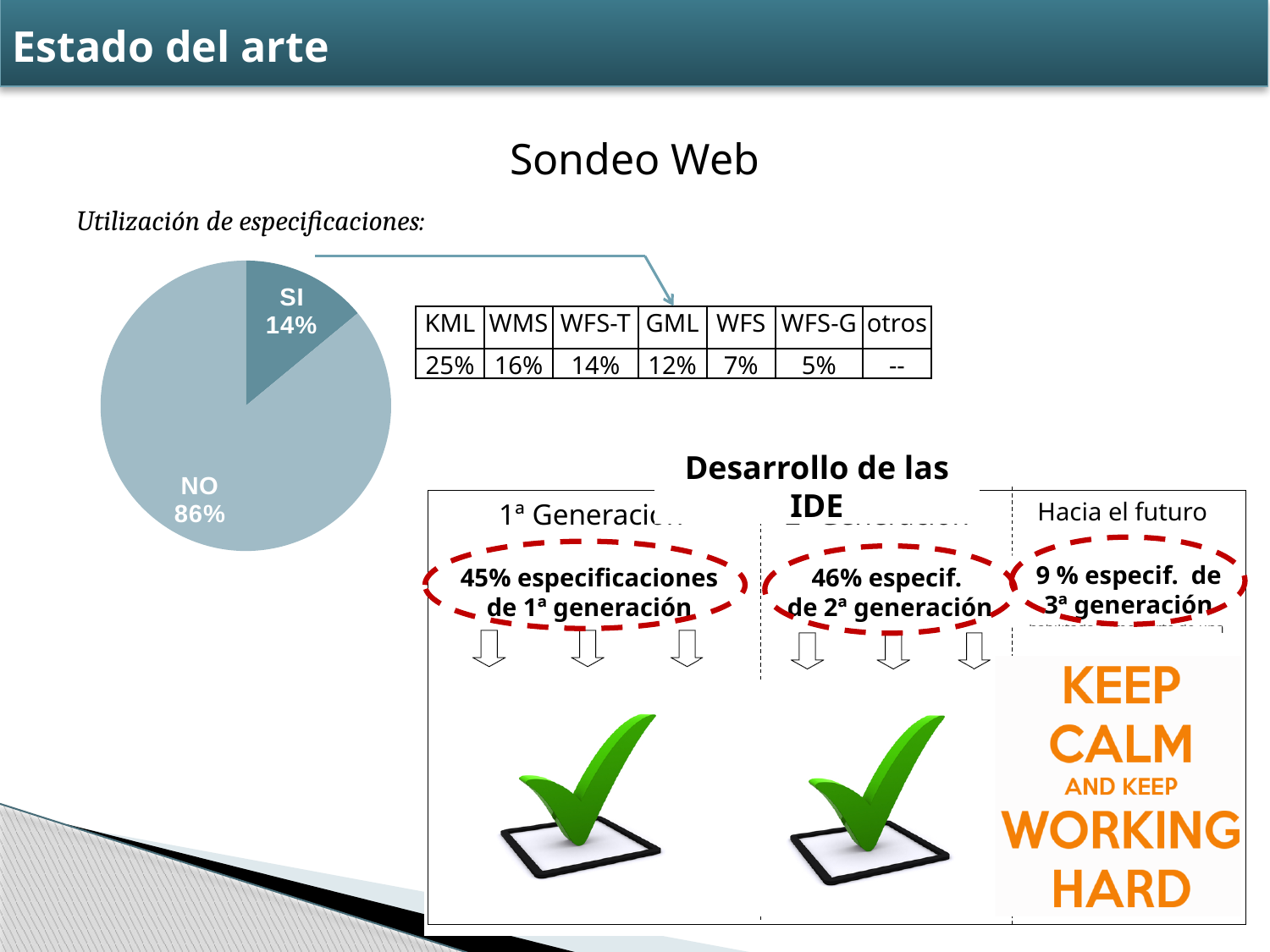
Which slice of the pie chart is the largest? NO What percentage does the "NO" slice of the pie chart represent? 86% What share of the pie chart does the "SI" slice take up? 14% What label appears above the pie chart describing what it shows? Utilización de especificaciones: What is the difference in percentage points between the "NO" and "SI" slices of the pie chart? 72 percentage points What percentage does the "SI" slice of the pie chart represent? 14% Which slice of the pie chart is drawn in the darker shade? SI Is the "NO" slice of the pie chart greater or less than 50%? greater Which is larger in the pie chart, "SI" or "NO"? NO What type of chart is shown on the left of the slide? Pie chart How many slices does the pie chart have? 2 Which slice of the pie chart is the smallest? SI